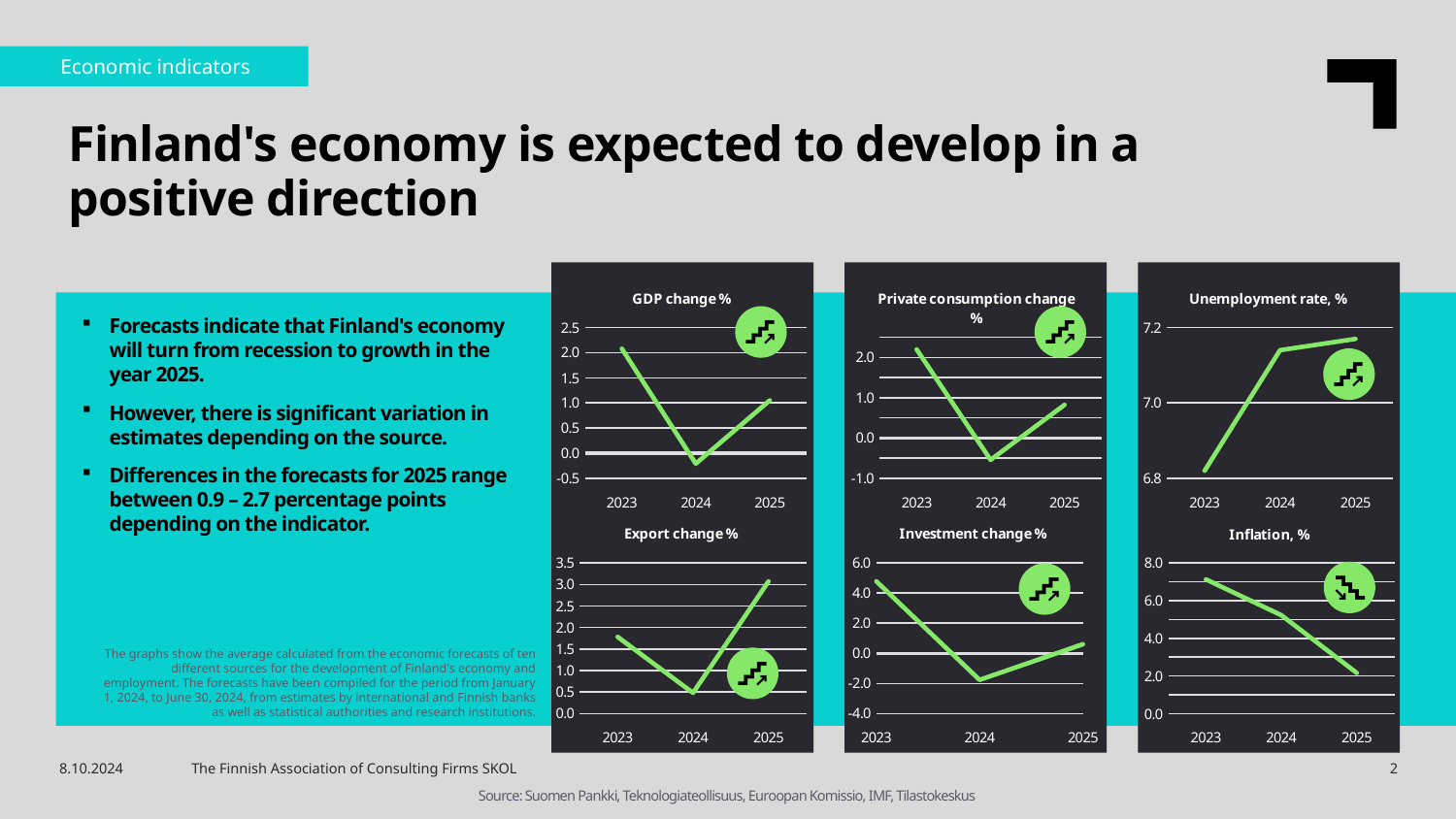
In the "Private consumption change %" chart, which is larger, the value for 2023 or the value for 2025? 2023 What kind of chart is the "GDP change %" chart? line chart In the "Inflation, %" chart, do the values rise or fall from 2023 to 2025? fall In the "Investment change %" chart, is the value for 2023 greater or less than 2.0? greater In the "Unemployment rate, %" chart, is the value for 2025 greater or less than 7.0? greater In the "Inflation, %" chart, is the value for 2024 greater or less than 4.0? greater In the "Export change %" chart, which year has the highest value? 2025 How many years are plotted on the x axis of the "Export change %" chart? 3 What is the title of the chart in the bottom-right position? Inflation, % In the "Unemployment rate, %" chart, which year has the lowest value? 2023 In the "GDP change %" chart, which year has the lowest value? 2024